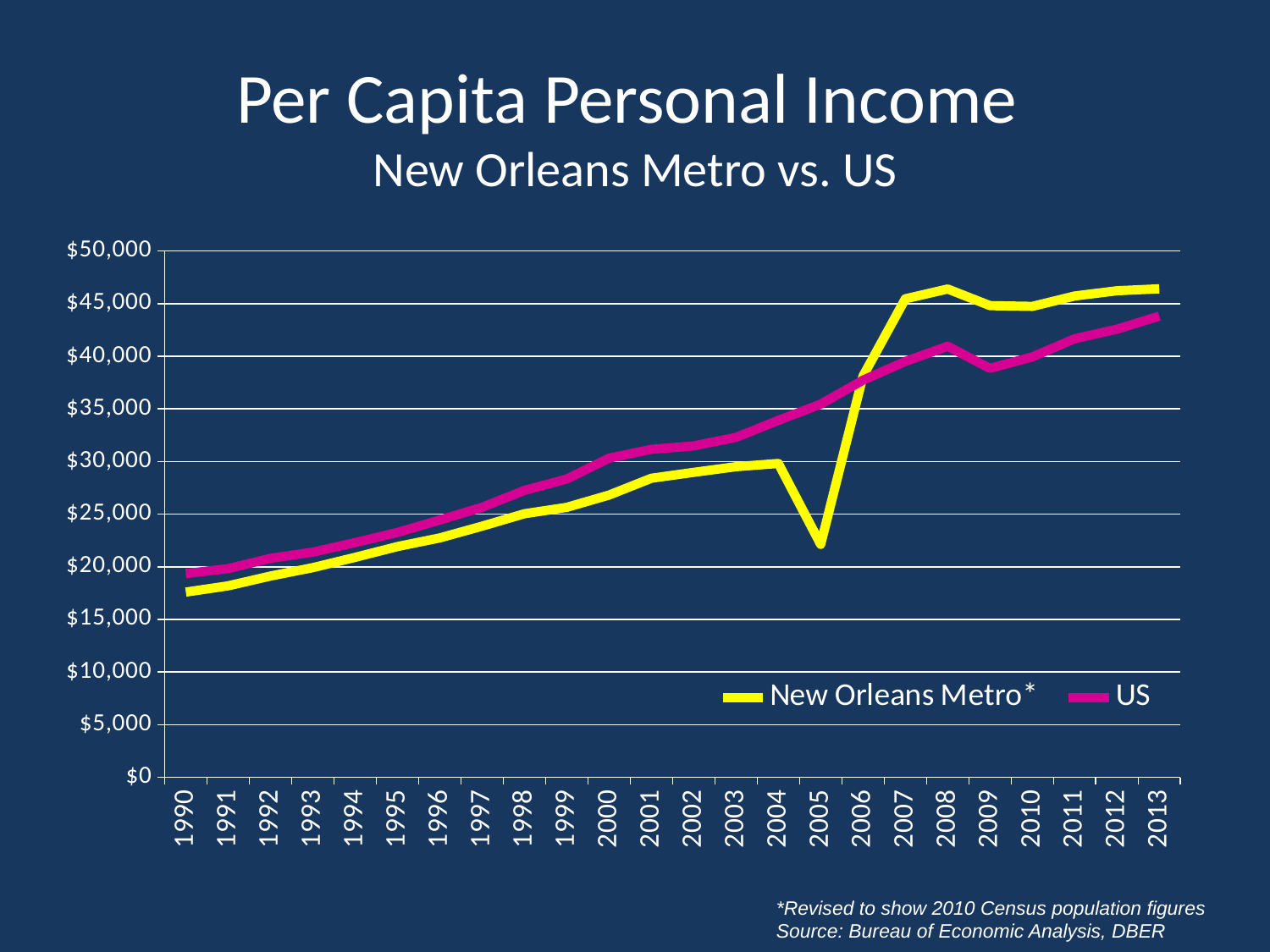
Which series is drawn in yellow? New Orleans Metro* In 2008, which series has the higher value, New Orleans Metro or US? New Orleans Metro What kind of chart is shown on the slide? Line chart Is the value for New Orleans Metro in 2005 greater or less than $25,000? less In which year is the US series at its lowest? 1990 Is the value for US in 2013 greater or less than $40,000? greater Is the value for New Orleans Metro in 1990 greater or less than $20,000? less In which year is the US series at its highest? 2013 What is the title of the chart? Per Capita Personal Income New Orleans Metro vs. US How many years are plotted along the x axis? 24 In 2005, which series has the higher value, New Orleans Metro or US? US How many series does the legend list? 2